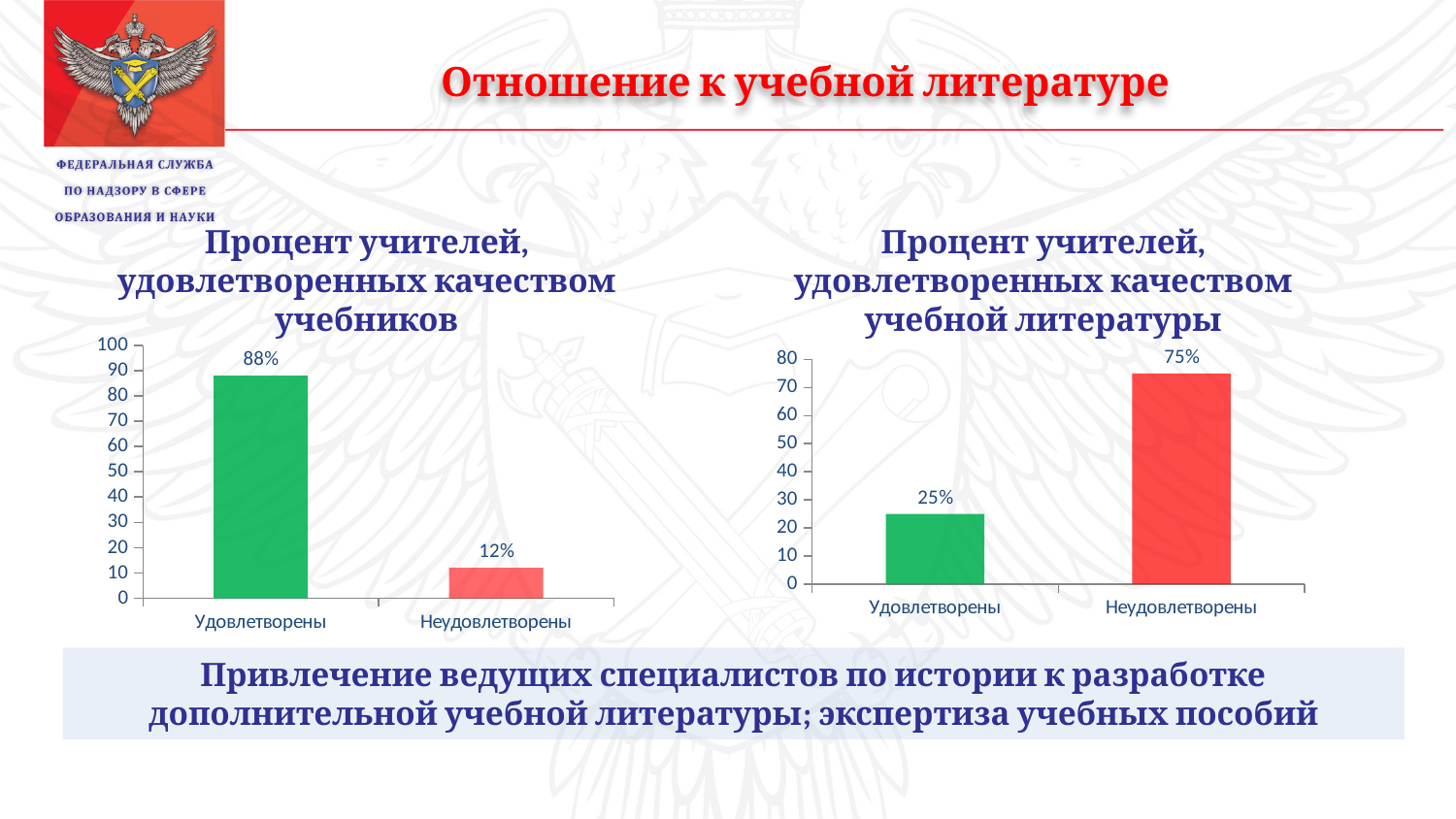
In the right chart, which category has the lowest value? Удовлетворены What type of chart is the right chart? Bar chart In the right chart (Процент учителей, удовлетворенных качеством учебной литературы), what is the value for Неудовлетворены? 75% In the right chart, what is the difference between Неудовлетворены and Удовлетворены? 50% In the right chart, which is larger: Удовлетворены or Неудовлетворены? Неудовлетворены In the left chart, what colour is the bar for Удовлетворены? Green In the left chart (Процент учителей, удовлетворенных качеством учебников), what is the value for Неудовлетворены? 12% In the left chart (Процент учителей, удовлетворенных качеством учебников), what is the value for Удовлетворены? 88% In the left chart, which category has the highest value? Удовлетворены In the right chart (Процент учителей, удовлетворенных качеством учебной литературы), what is the value for Удовлетворены? 25% In the left chart, what is the difference between Удовлетворены and Неудовлетворены? 76% How many categories does the left chart show? 2